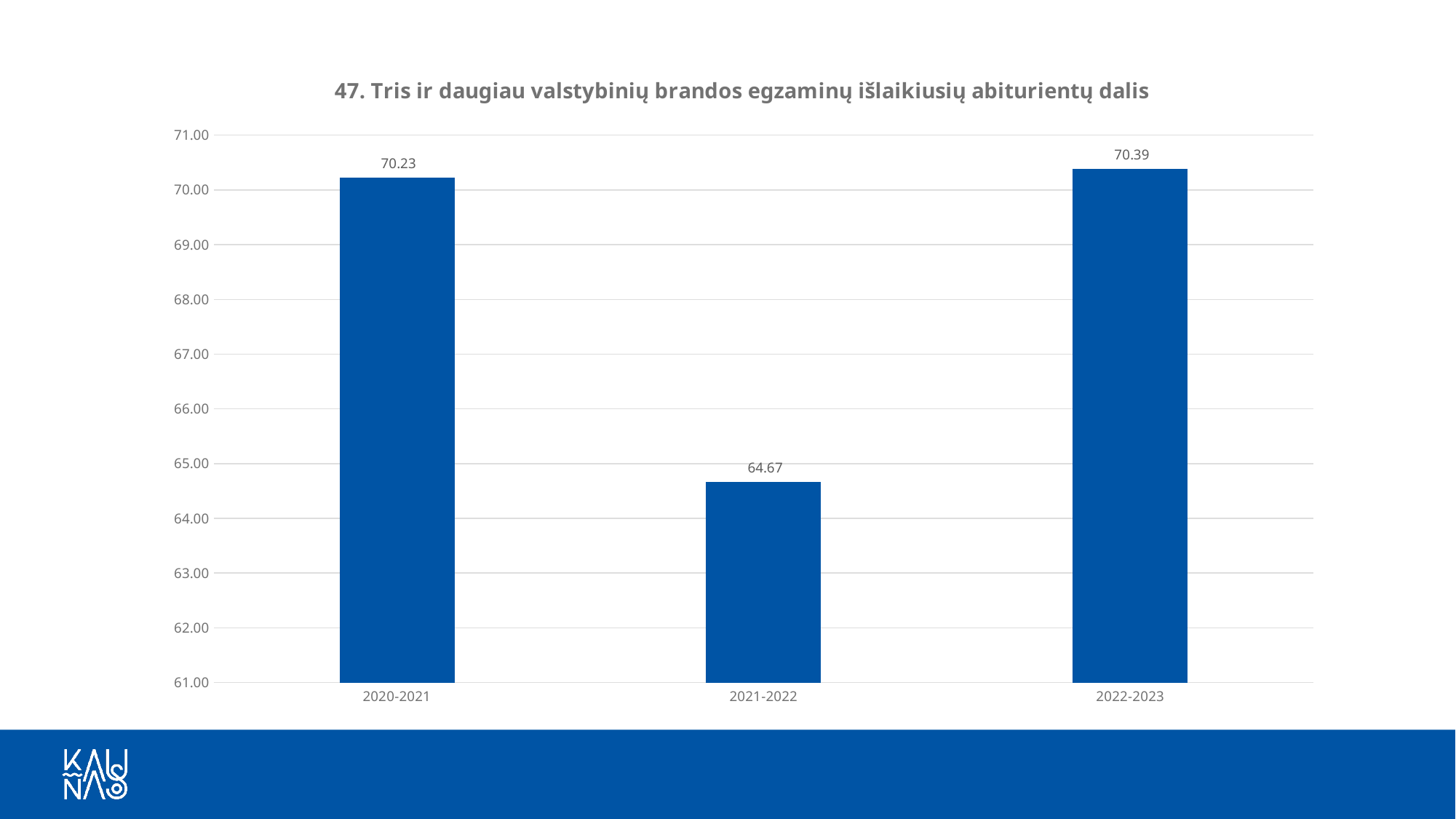
What is the value for 2022-2023? 70.39 What is the value for 2020-2021? 70.23 Which is larger, the value for 2020-2021 or the value for 2021-2022? 2020-2021 What kind of chart is shown on the slide? bar chart What is the difference between the values for 2020-2021 and 2021-2022? 5.56 Which school year has the highest value? 2022-2023 Is the value for 2021-2022 greater or less than 65.00? less What is the difference between the values for 2022-2023 and 2021-2022? 5.72 What is the value for 2021-2022? 64.67 What is the title of the chart? 47. Tris ir daugiau valstybinių brandos egzaminų išlaikiusių abiturientų dalis How many school years are shown on the chart? 3 Which school year has the lowest value? 2021-2022